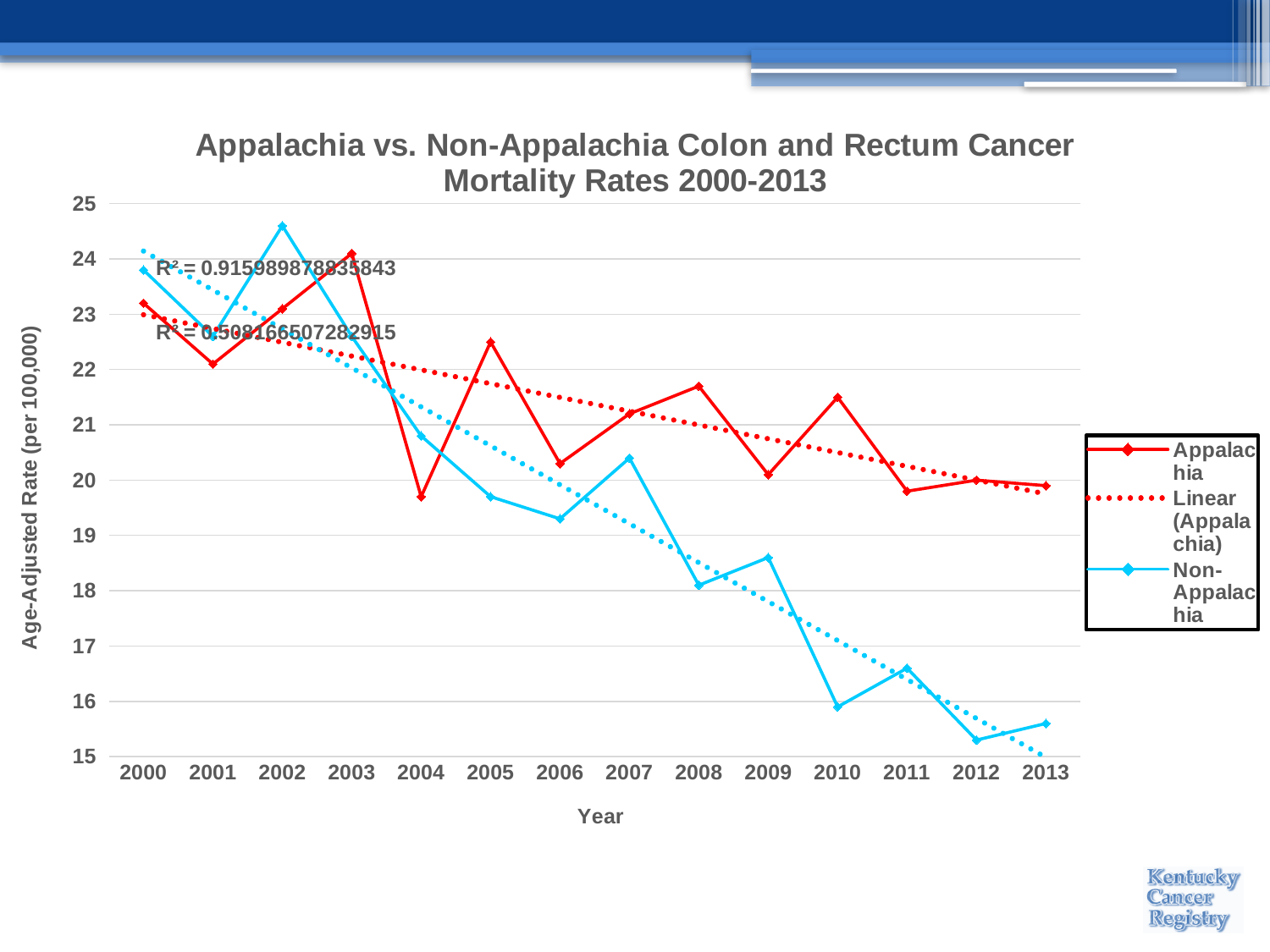
Overall, do the Non-Appalachia values rise or fall from 2000 to 2013? fall How many entries does the legend list? 3 How many years are plotted along the x axis? 14 What is the label on the y axis? Age-Adjusted Rate (per 100,000) Is the Non-Appalachia value for 2012 greater or less than 16? less In 2010, which series has the higher value, Appalachia or Non-Appalachia? Appalachia Is the Appalachia value for 2003 greater or less than 23? greater In which year does the Non-Appalachia series reach its highest value? 2002 Is the Non-Appalachia value for 2008 greater or less than 19? less What kind of chart is shown on the slide? Line chart In which year does the Appalachia series reach its highest value? 2003